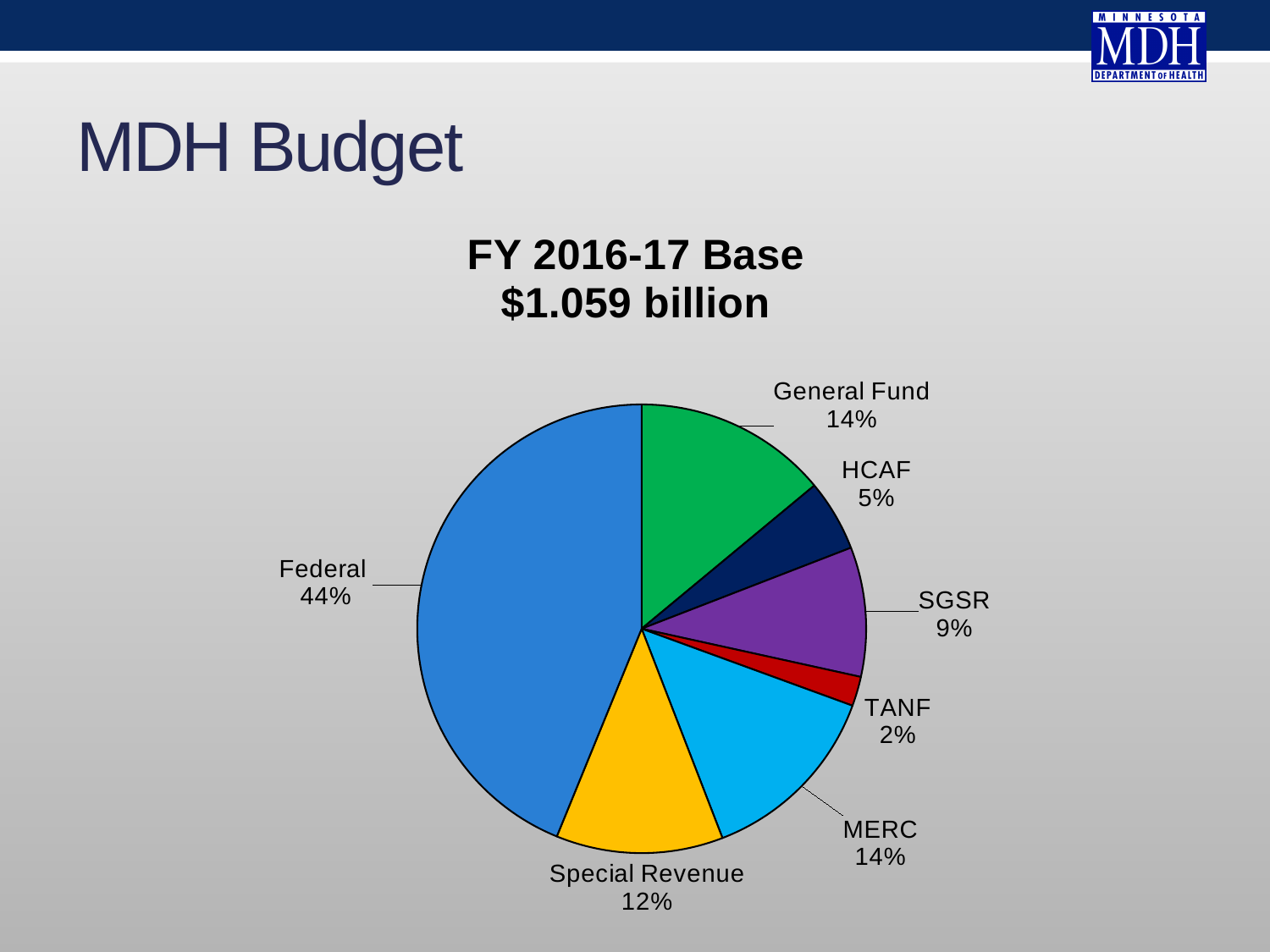
Which funding source has the smallest share of the budget? TANF Which funding source has the largest share of the budget? Federal What percentage is shown for TANF? 2% Which is larger, the share for HCAF or the share for SGSR? SGSR What type of chart is shown on the slide? pie chart What is the difference in percentage points between Federal and Special Revenue? 32 What colour is the Federal slice? blue What percentage of the budget comes from the General Fund? 14% What is the share for SGSR? 9% What is the total budget amount stated in the chart title? $1.059 billion What share of the FY 2016-17 base budget is Federal? 44% How many slices does the pie chart have? 7